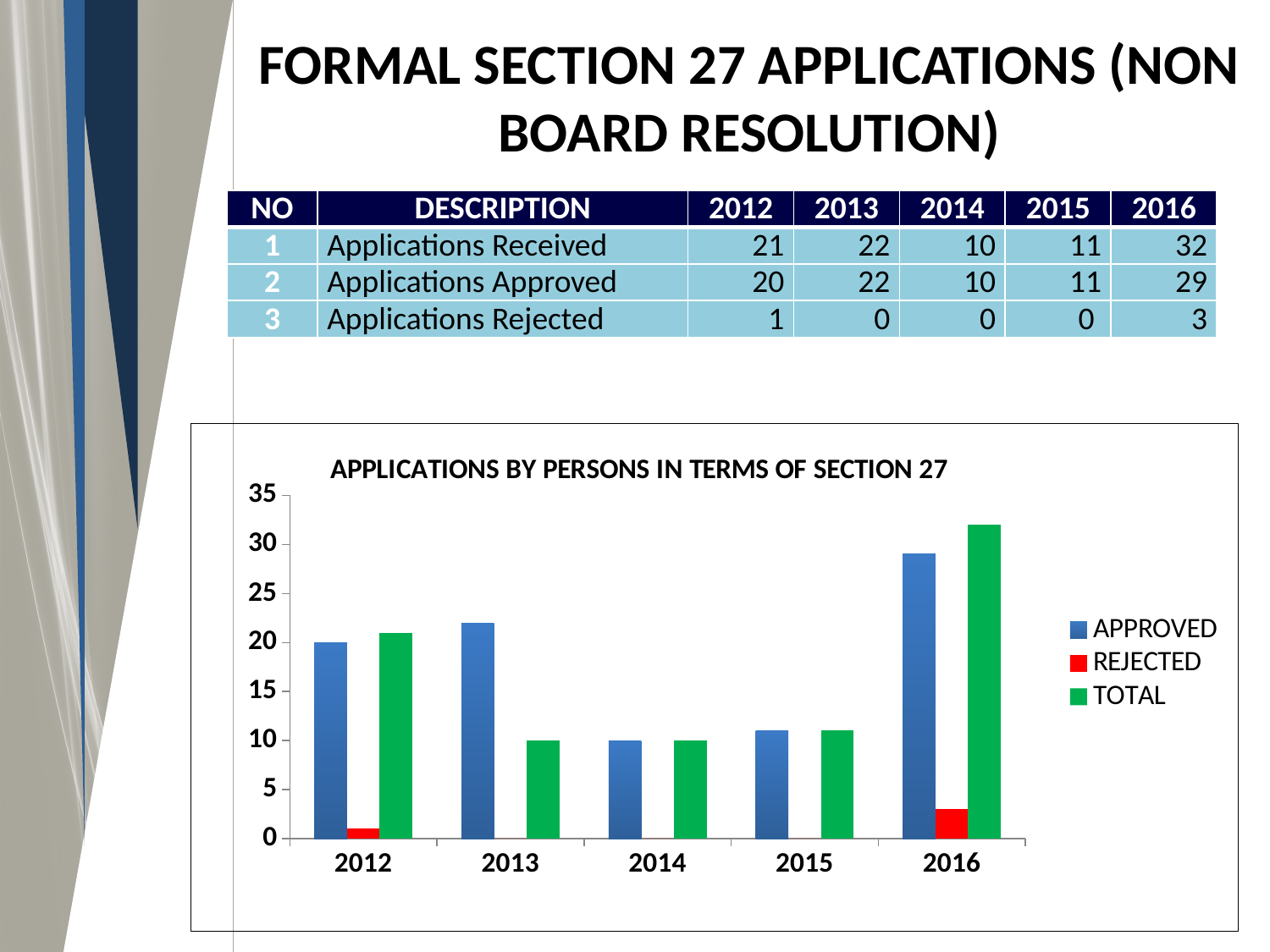
What is the APPROVED value for 2014 in the chart? 10 What is the APPROVED value for 2012 in the chart? 20 Which year has the larger APPROVED bar, 2013 or 2015? 2013 How many series does the chart legend list? 3 Is the TOTAL value for 2016 greater or less than 30? greater Which year has the highest TOTAL bar in the chart? 2016 What kind of chart is shown on the slide? bar chart How many years are shown along the x axis of the chart? 5 Is the APPROVED value for 2016 greater or less than 25? greater What is the title of the chart? APPLICATIONS BY PERSONS IN TERMS OF SECTION 27 What is the TOTAL value for 2014 in the chart? 10